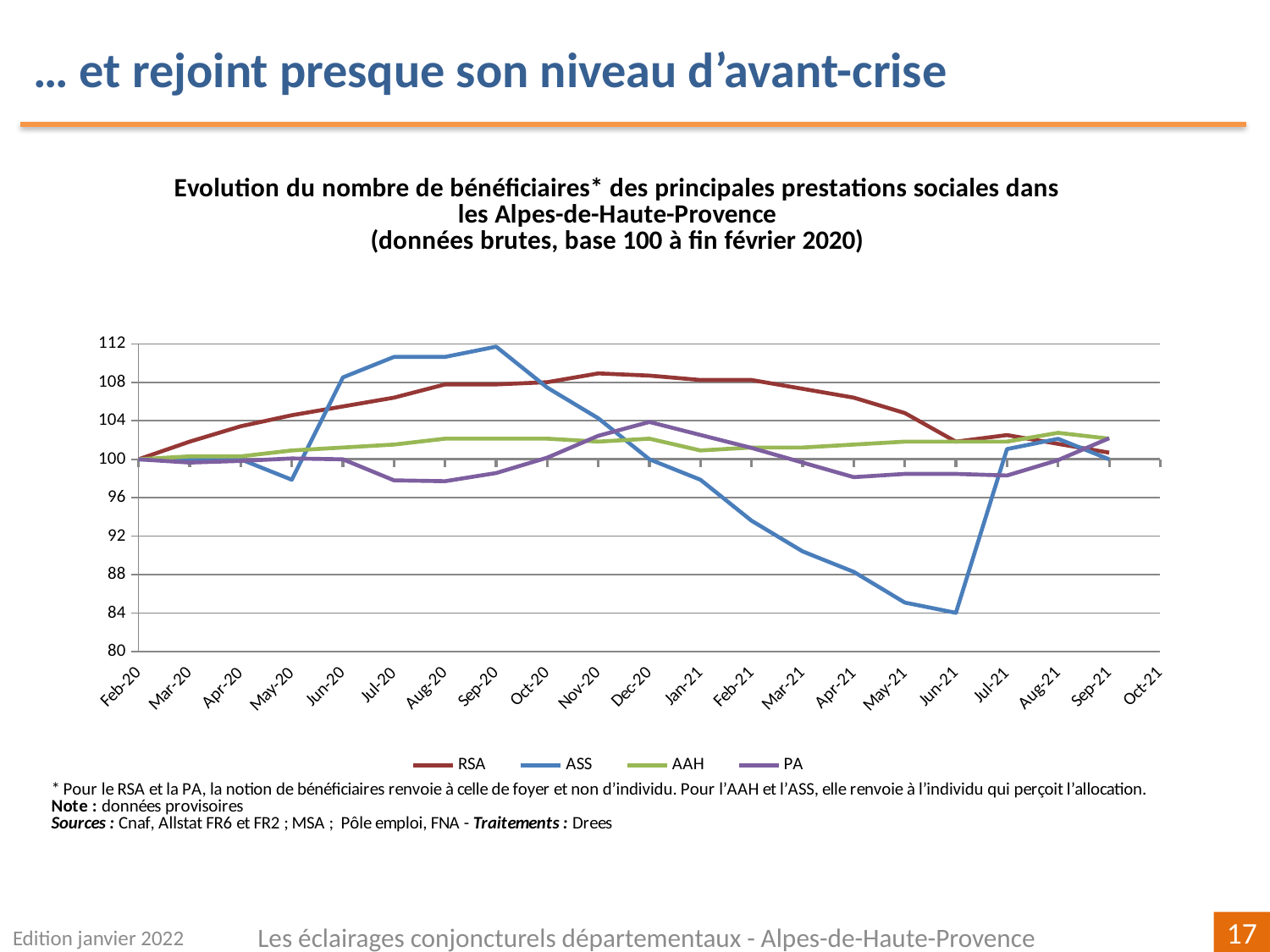
Which series has the lowest value in Jun-21? ASS Is the value for ASS in Sep-20 greater or less than 108? greater What kind of chart is shown on the slide? line chart Does the ASS series rise or fall between Sep-20 and Jun-21? fall Is the value for ASS in Jun-21 greater or less than 88? less What is the value of the RSA series in Feb-20? 100 Which series are listed in the chart legend? RSA, ASS, AAH, PA Is the value for PA in Jul-20 greater or less than 100? less Which series has the highest value in Sep-20? ASS Which series has the highest value in Nov-20? RSA In Mar-21, which series has the larger value, RSA or ASS? RSA How many series does the chart legend list? 4